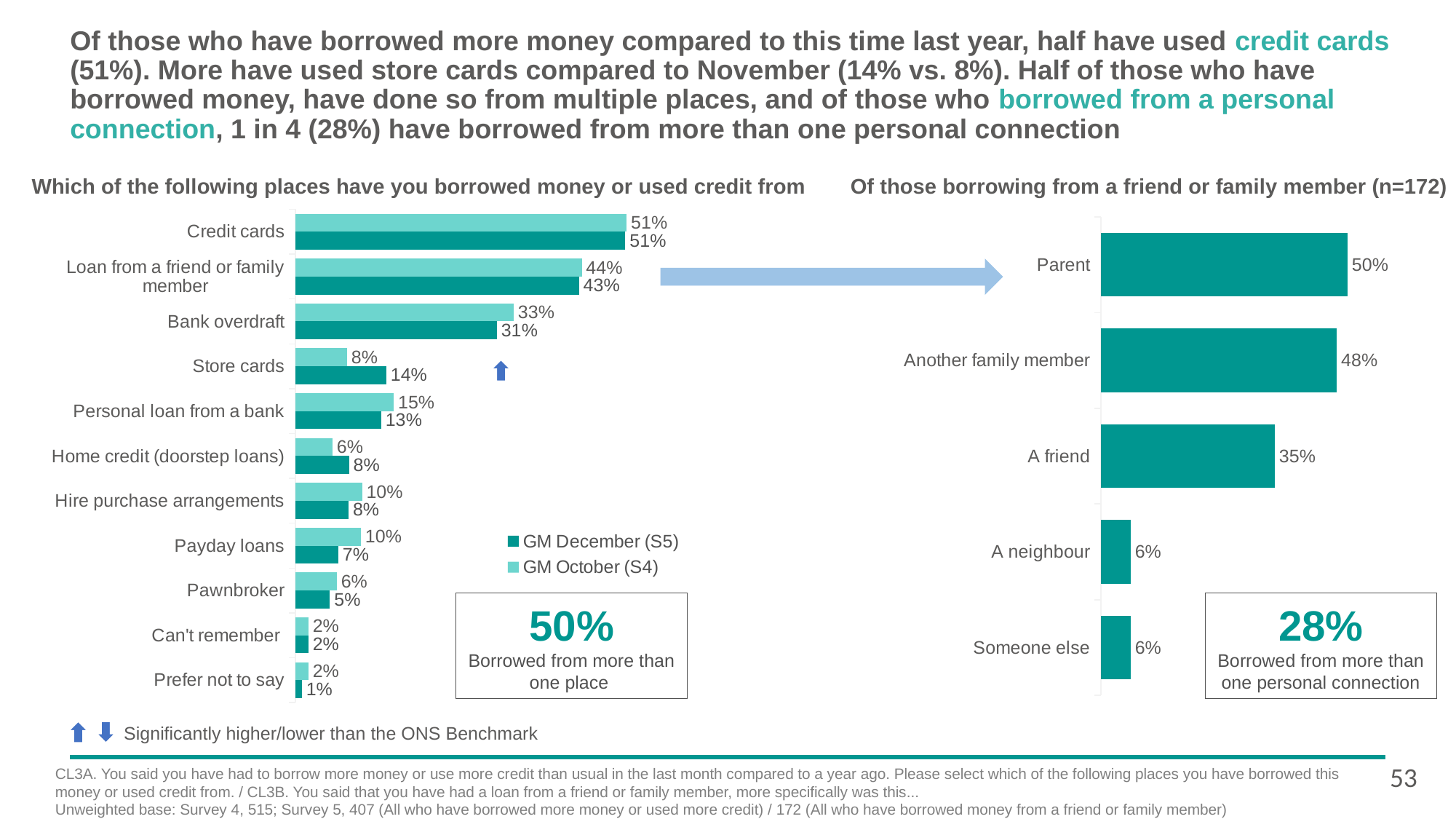
In the chart 'Of those borrowing from a friend or family member (n=172)', what is the difference between Parent and Another family member? 2% In the chart 'Which of the following places have you borrowed money or used credit from', what is the difference between the GM December (S5) and GM October (S4) values for Store cards? 6% In the chart 'Which of the following places have you borrowed money or used credit from', what is the GM October (S4) value for Bank overdraft? 33% How many categories are shown in the chart 'Which of the following places have you borrowed money or used credit from'? 11 What type of chart is 'Of those borrowing from a friend or family member (n=172)'? Bar chart In the chart 'Which of the following places have you borrowed money or used credit from', which category has the highest GM December (S5) value? Credit cards In the chart 'Which of the following places have you borrowed money or used credit from', which is larger for Personal loan from a bank: GM December (S5) or GM October (S4)? GM October (S4) How many series does the legend list in the chart 'Which of the following places have you borrowed money or used credit from'? 2 In the chart 'Which of the following places have you borrowed money or used credit from', what is the GM December (S5) value for Payday loans? 7% In the chart 'Which of the following places have you borrowed money or used credit from', what is the GM December (S5) value for Store cards? 14% In the chart 'Of those borrowing from a friend or family member (n=172)', what is the value for A friend? 35% In the chart 'Of those borrowing from a friend or family member (n=172)', which category has the highest value? Parent